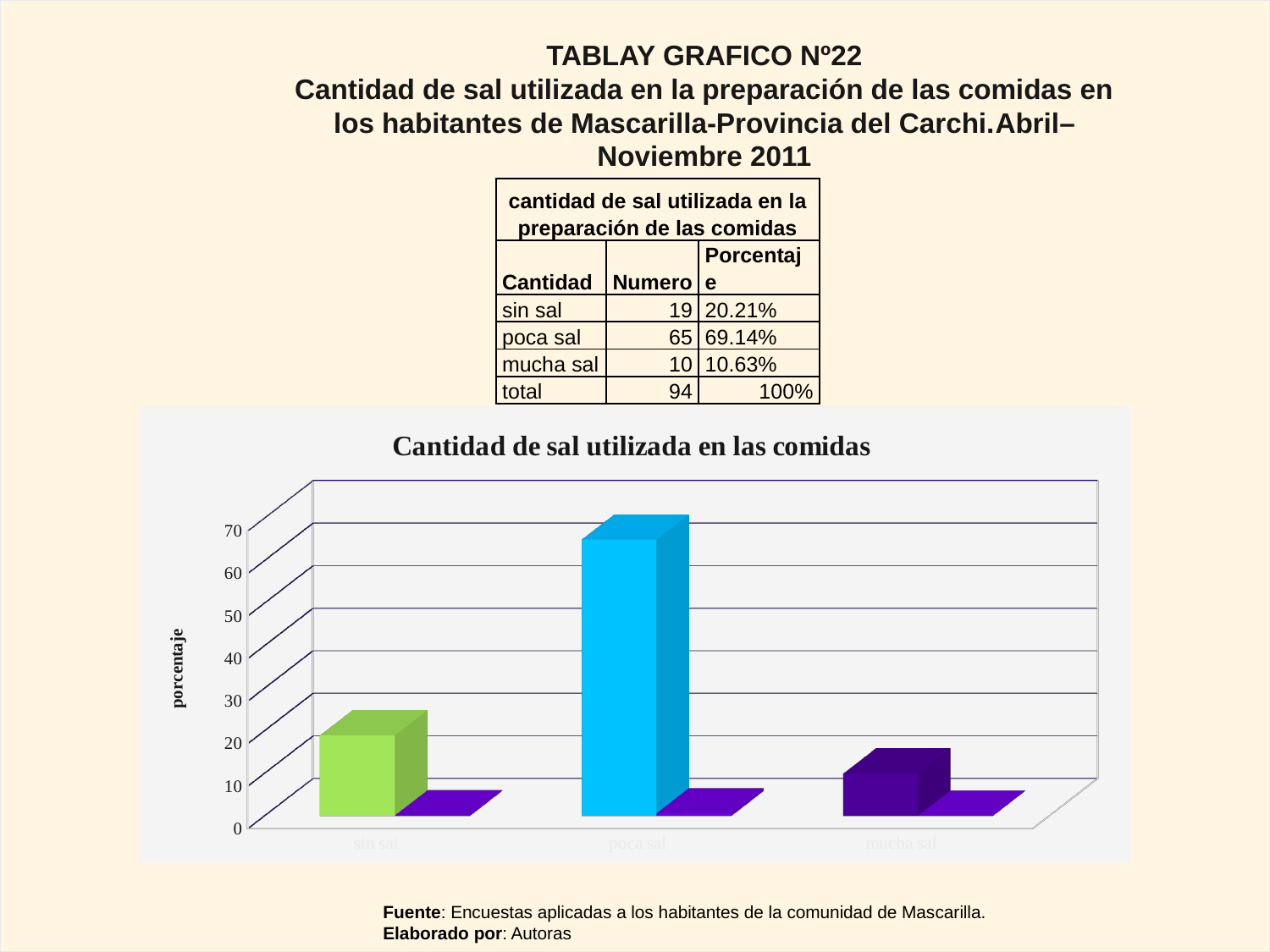
Is the value for poca sal in the chart greater or less than 60? greater What is the label of the chart's vertical axis? porcentaje What is the title of the chart? Cantidad de sal utilizada en las comidas What kind of chart is shown on the slide? bar chart How many categories are plotted on the chart's x axis? 3 Is the value for sin sal in the chart greater or less than 30? less According to the table, what percentage corresponds to poca sal? 69.14% Which bar is taller in the chart, sin sal or mucha sal? sin sal Which category has the lowest bar in the chart? mucha sal Is the value for mucha sal in the chart greater or less than 20? less According to the table, what is the Numero for sin sal? 19 Which category has the highest bar in the chart? poca sal